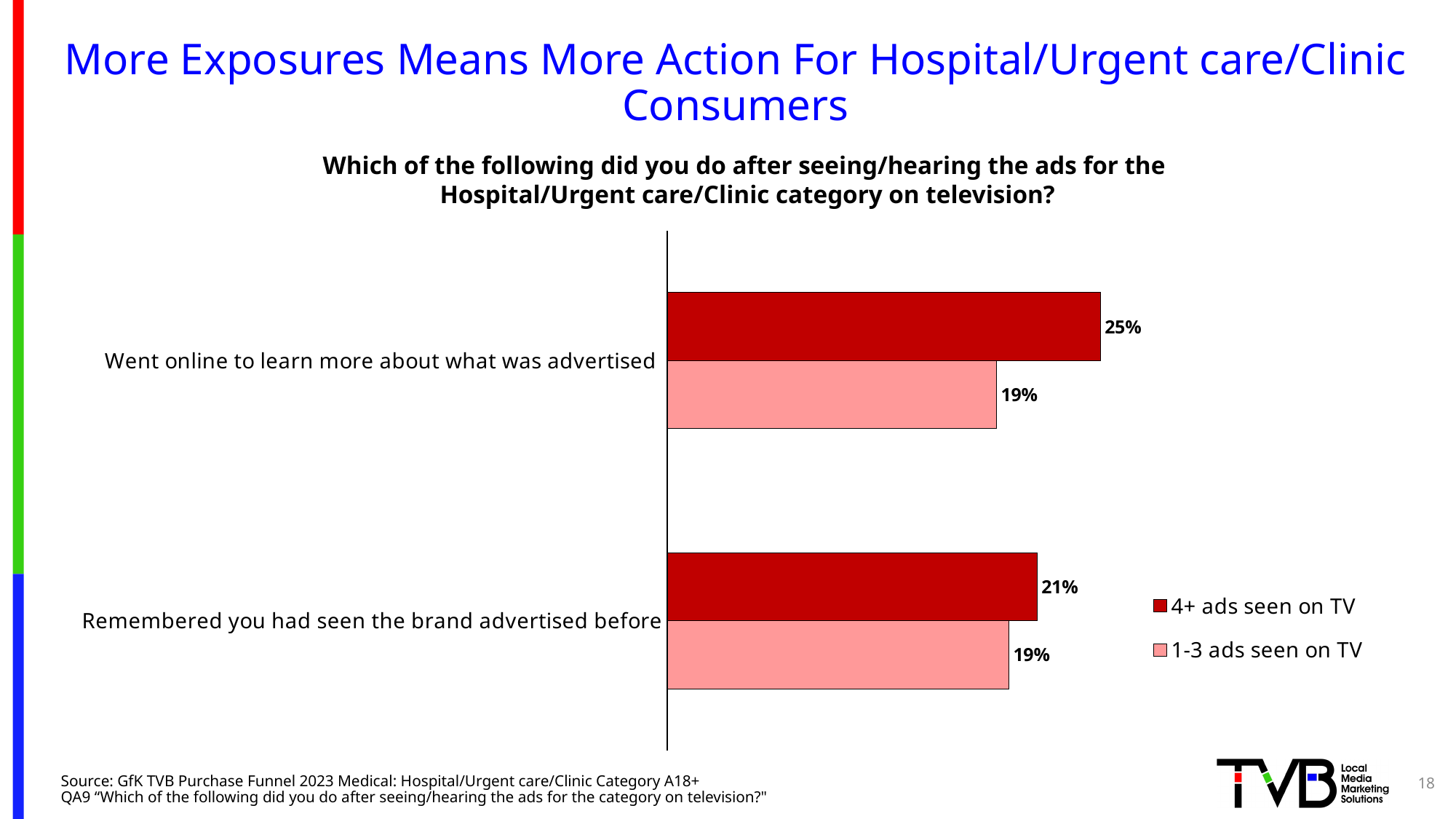
Which bar has the highest value on the chart? 4+ ads seen on TV, Went online to learn more about what was advertised What percentage of consumers who saw 1-3 ads on TV remembered they had seen the brand advertised before? 19% How many series does the legend list? 2 What percentage of consumers who saw 4+ ads on TV went online to learn more about what was advertised? 25% Which series is shown in dark red in the legend? 4+ ads seen on TV For 'Remembered you had seen the brand advertised before', which group has the larger value: 4+ ads seen on TV or 1-3 ads seen on TV? 4+ ads seen on TV What is the difference between the 4+ ads and 1-3 ads values for 'Went online to learn more about what was advertised'? 6% What percentage of consumers who saw 1-3 ads on TV went online to learn more about what was advertised? 19% What percentage of consumers who saw 4+ ads on TV remembered they had seen the brand advertised before? 21% What is the difference between the 4+ ads and 1-3 ads values for 'Remembered you had seen the brand advertised before'? 2% What type of chart is shown on the slide? Bar chart How many categories (actions) are shown on the chart? 2